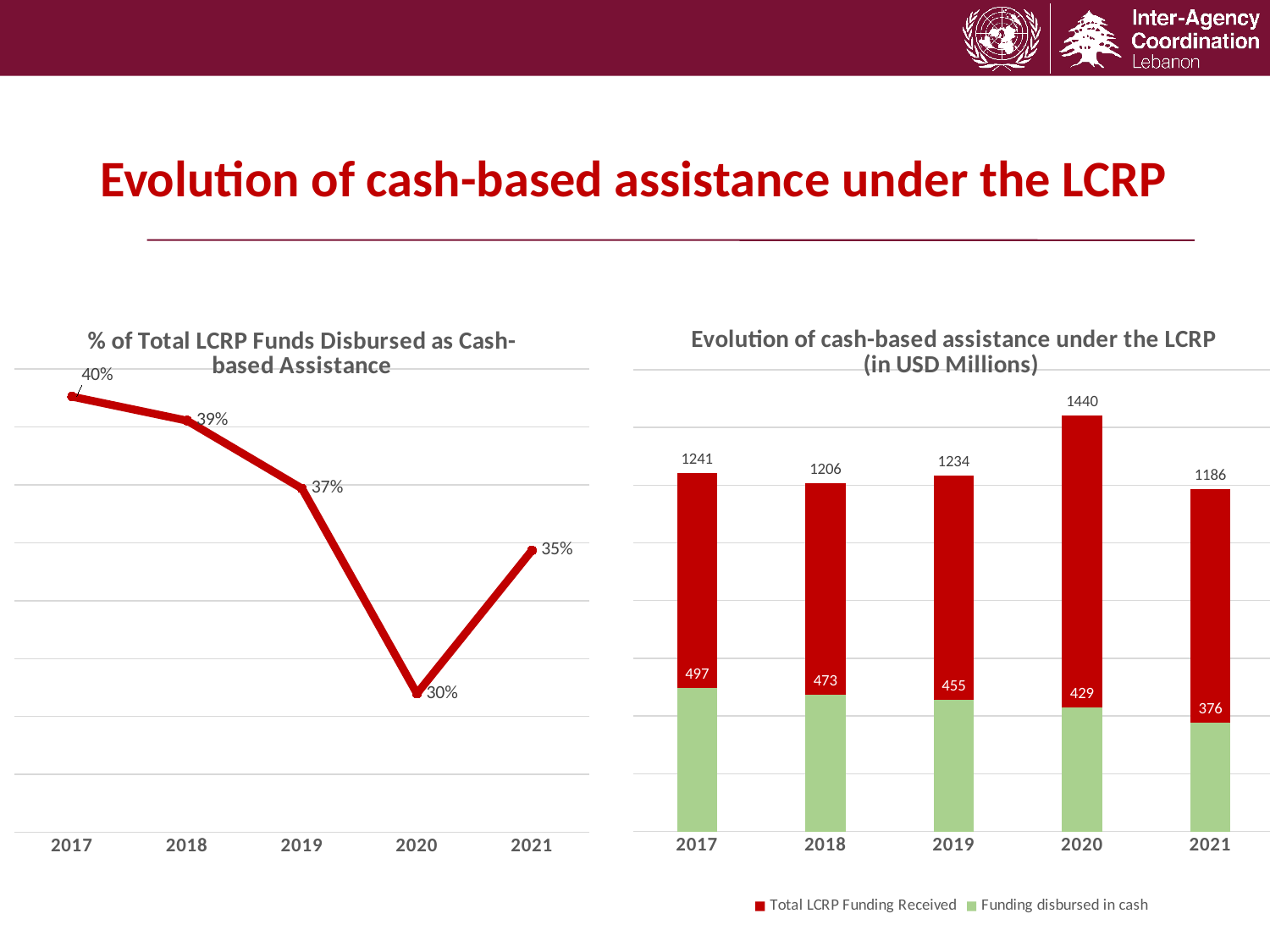
In the left chart, which year has the highest percentage? 2017 In the left chart, what is the value for 2020? 30% How many series does the legend of the right chart list? 2 In the left chart, which year has the lowest percentage? 2020 What kind of chart is the left chart? line chart In the right chart, what is the difference between Funding disbursed in cash in 2017 and 2018? 24 In the right chart, what is the Total LCRP Funding Received value labelled for 2020? 1440 In the right chart, which year has the lowest Funding disbursed in cash? 2021 In the left chart, do the values rise or fall from 2017 to 2020? fall In the right chart, what is the Funding disbursed in cash value for 2021? 376 In the left chart, what percentage of total LCRP funds was disbursed as cash-based assistance in 2017? 40% In the left chart, what is the difference between the 2019 and 2020 values? 7%